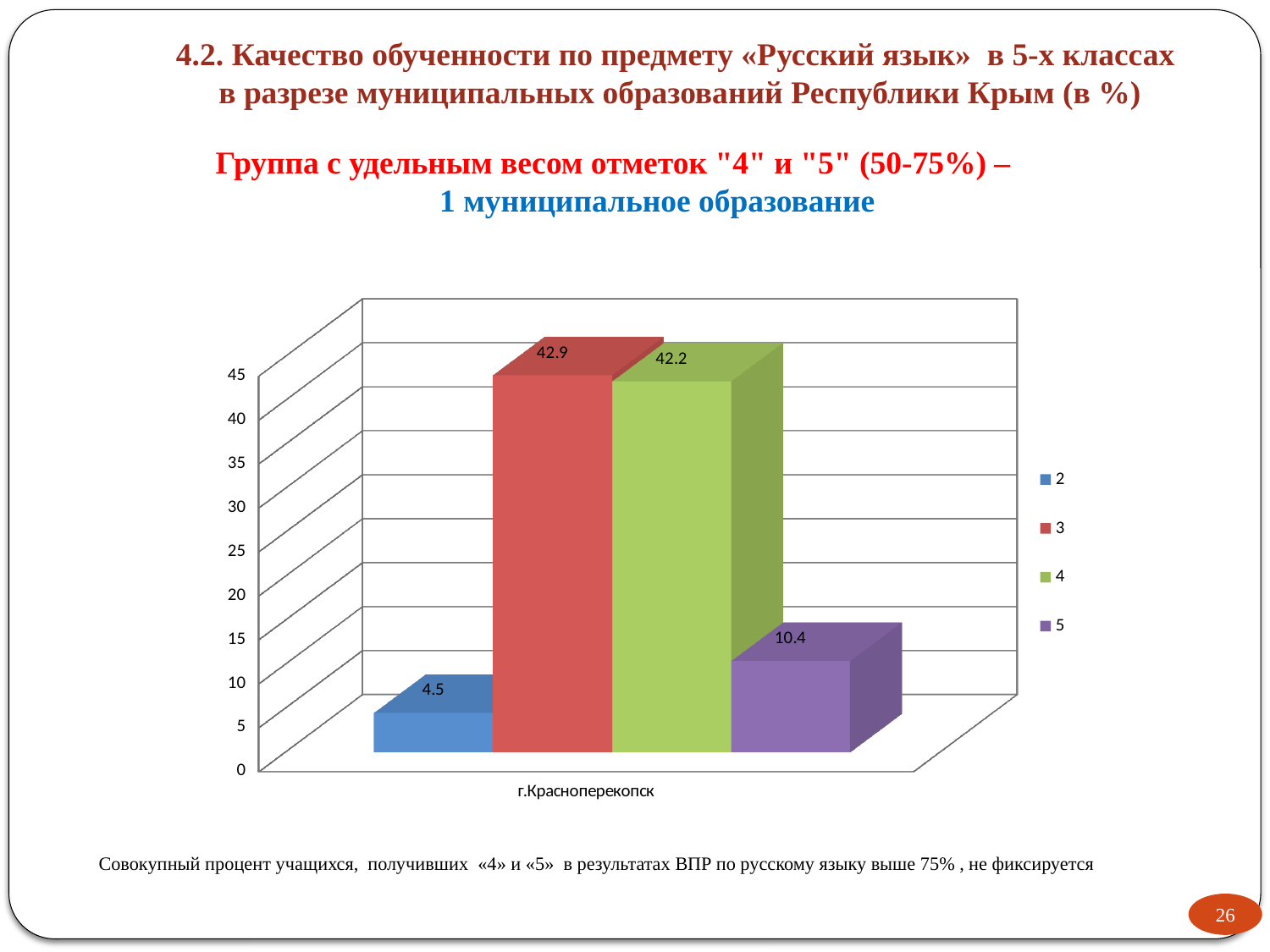
What is the difference between the values for series 3 and series 4? 0.7 How many series does the legend list? 4 Which series has the lowest value for г.Красноперекопск? 2 What is the category label shown on the x axis of the chart? г.Красноперекопск Which series has the highest value for г.Красноперекопск? 3 What kind of chart is shown on the slide? bar chart What is the value for series 2 for г.Красноперекопск? 4.5 What is the value for series 5 for г.Красноперекопск? 10.4 What is the value for series 3 for г.Красноперекопск? 42.9 What is the difference between the values for series 5 and series 2? 5.9 Which is larger, the value for series 5 or the value for series 2? 5 What is the value for series 4 for г.Красноперекопск? 42.2